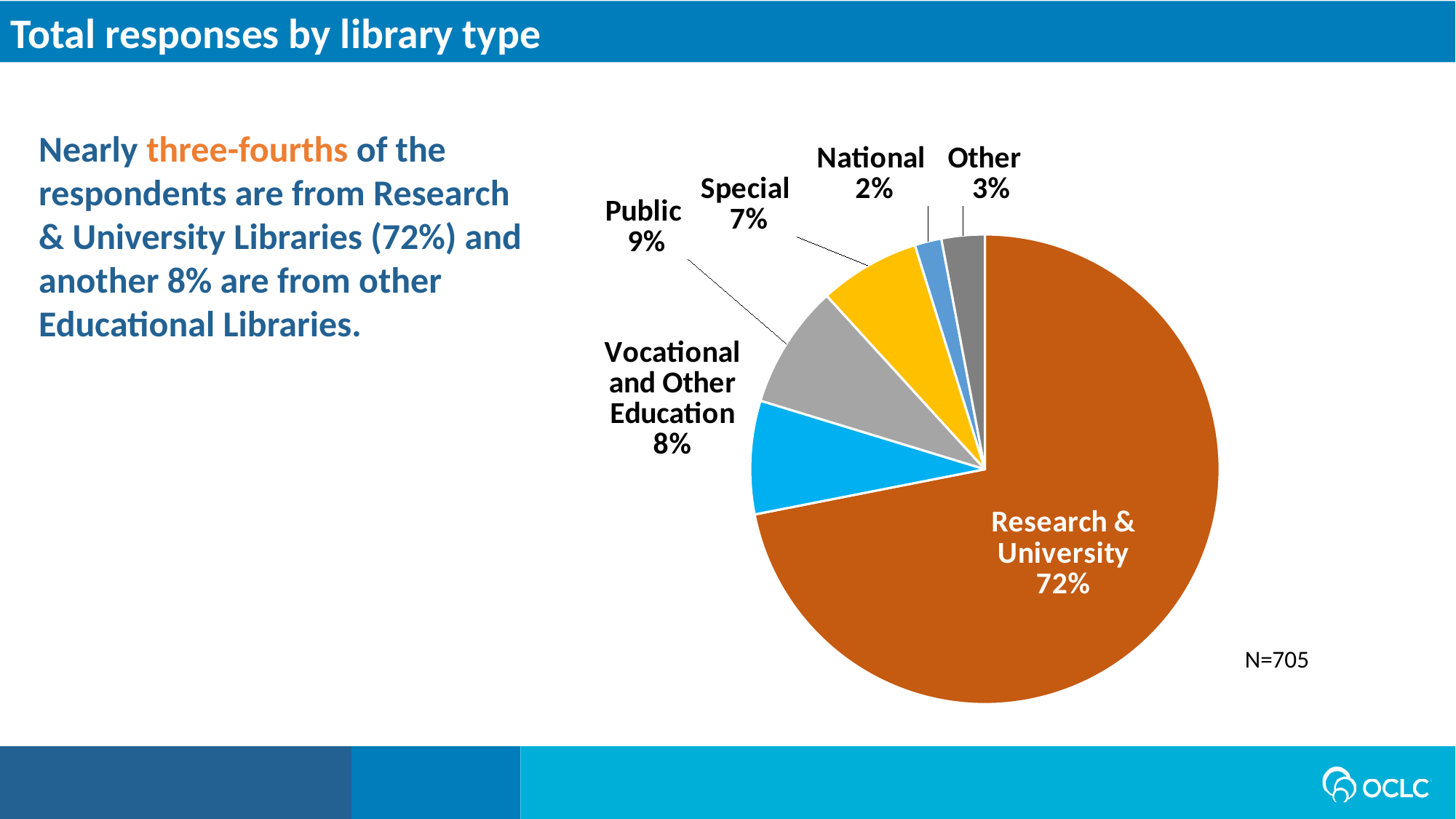
What is the total number of responses (N) shown on the slide? 705 Which library type has the largest share of responses? Research & University What share of responses comes from National libraries? 2% What share of responses comes from Research & University libraries? 72% Which library type has the smallest share of responses? National Which has a larger share of responses, Vocational and Other Education or Other? Vocational and Other Education What share of responses comes from Vocational and Other Education libraries? 8% What share of responses comes from Special libraries? 7% How many library types are shown in the pie chart? 6 What is the difference in percentage points between the Public and Special library shares? 2% What share of responses comes from Public libraries? 9% What kind of chart is shown on the slide? pie chart